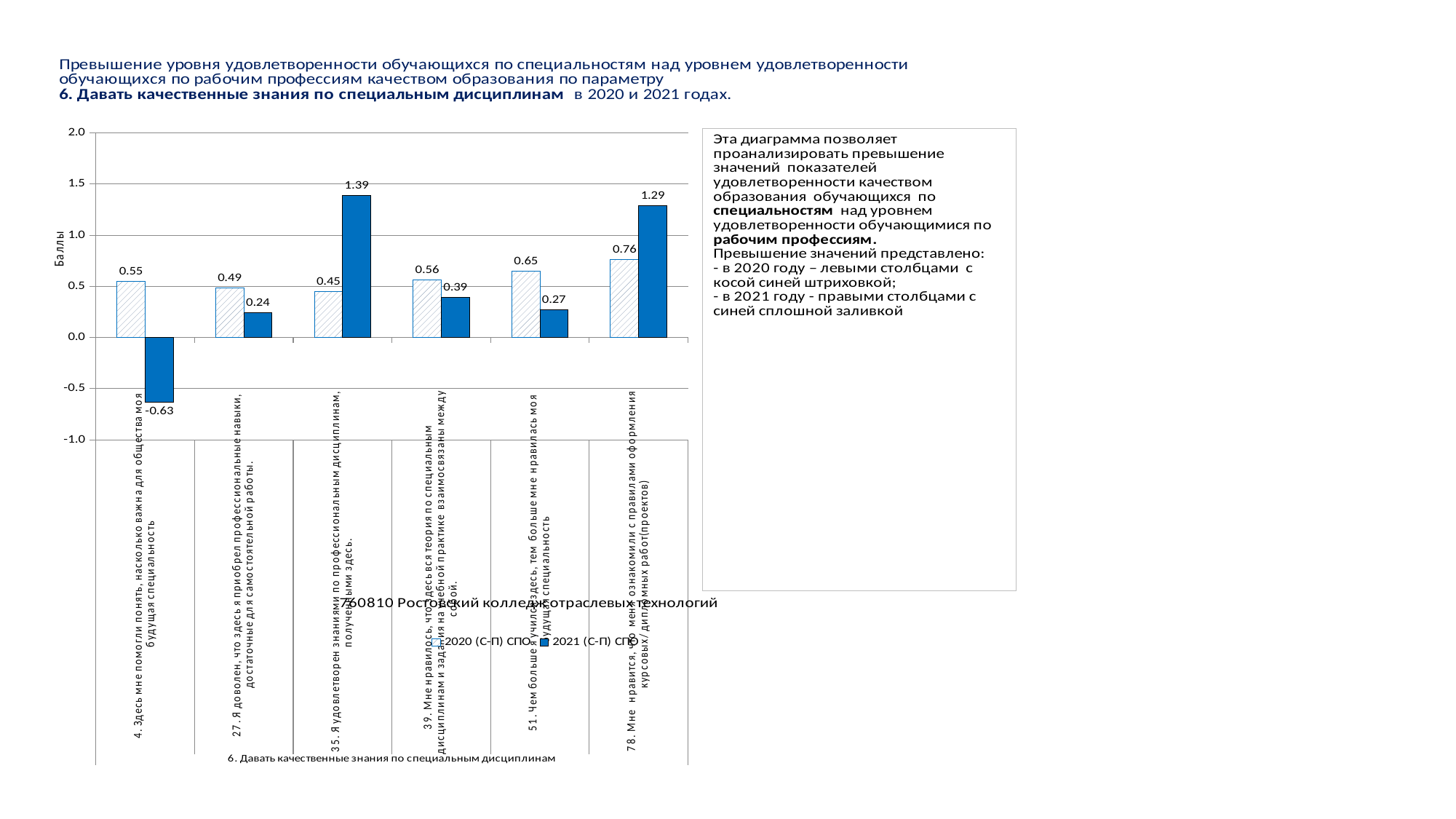
What is the difference between the 2021 and 2020 values for category 35? 0.94 What is the value of the 2020 (С-П) СПО series for category 4 (Здесь мне помогли понять, насколько важна для общества моя будущая специальность)? 0.55 What is the value of the 2021 (С-П) СПО series for category 35 (Я удовлетворен знаниями по профессиональным дисциплинам)? 1.39 How many series does the chart legend list? 2 What is the label of the vertical axis of the chart? Баллы Which category has the highest value in the 2021 (С-П) СПО series? 35. Я удовлетворен знаниями по профессиональным дисциплинам, полученными здесь What is the value of the 2021 (С-П) СПО series for category 4 (Здесь мне помогли понять, насколько важна для общества моя будущая специальность)? -0.63 Which category has the lowest value in the 2021 (С-П) СПО series? 4. Здесь мне помогли понять, насколько важна для общества моя будущая специальность How many categories (questions) are plotted on the x axis of the chart? 6 For category 51, which series has the larger value: 2020 (С-П) СПО or 2021 (С-П) СПО? 2020 (С-П) СПО What kind of chart is shown on the slide? bar chart Which category has the highest value in the 2020 (С-П) СПО series? 78. Мне нравится, что меня ознакомили с правилами оформления курсовых/дипломных работ(проектов)